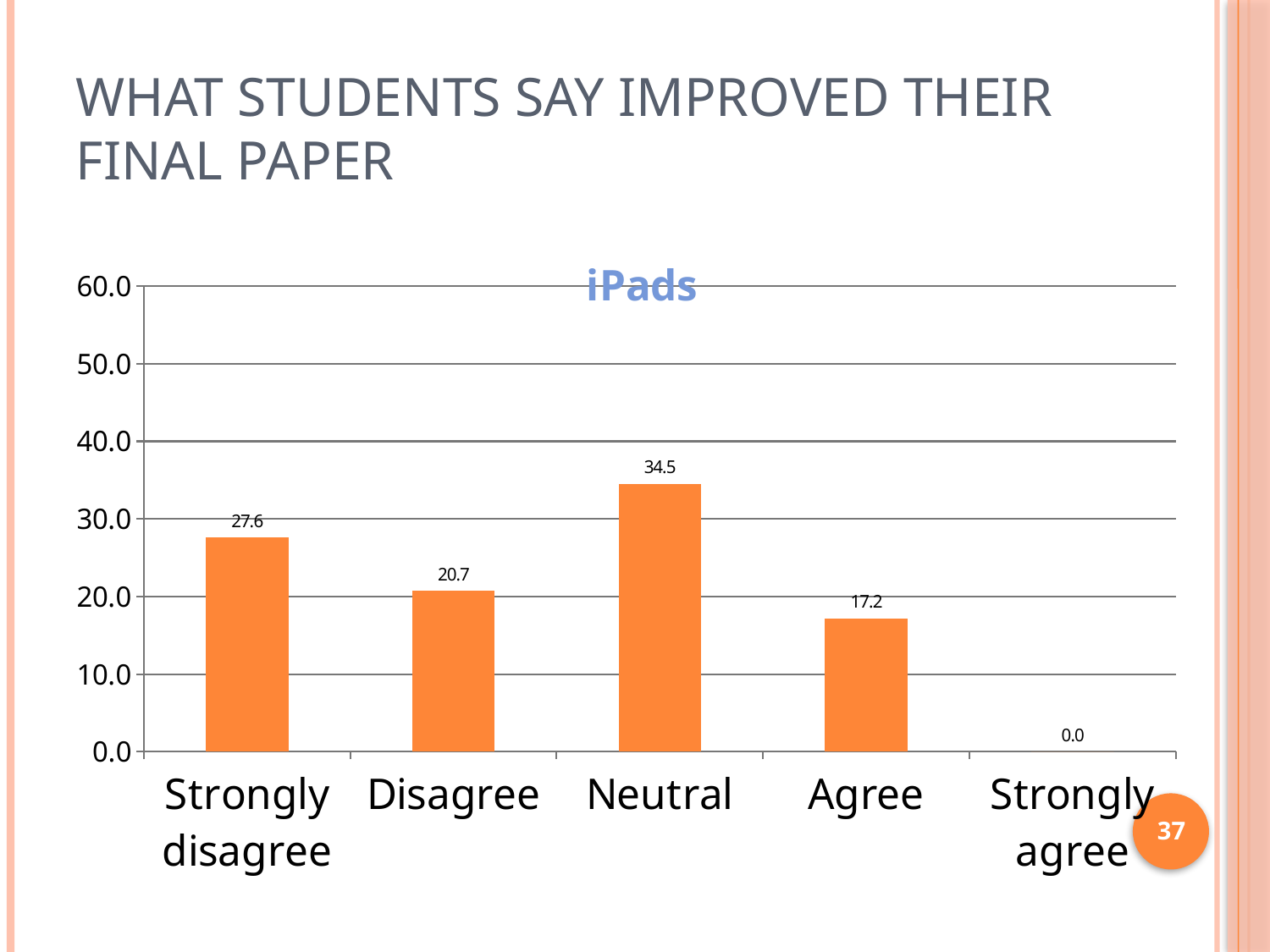
What is the value for Agree? 17.2 Which is larger, the value for Strongly disagree or the value for Agree? Strongly disagree Which category has the highest value? Neutral Which category has the lowest value? Strongly agree What kind of chart is shown on the slide? bar chart What is the difference between the values for Neutral and Disagree? 13.8 What is the title of the chart? iPads What is the value for Neutral? 34.5 What is the value for Strongly disagree? 27.6 What is the value for Strongly agree? 0.0 How many categories are shown on the x axis? 5 Is the value for Disagree greater or less than 30.0? less